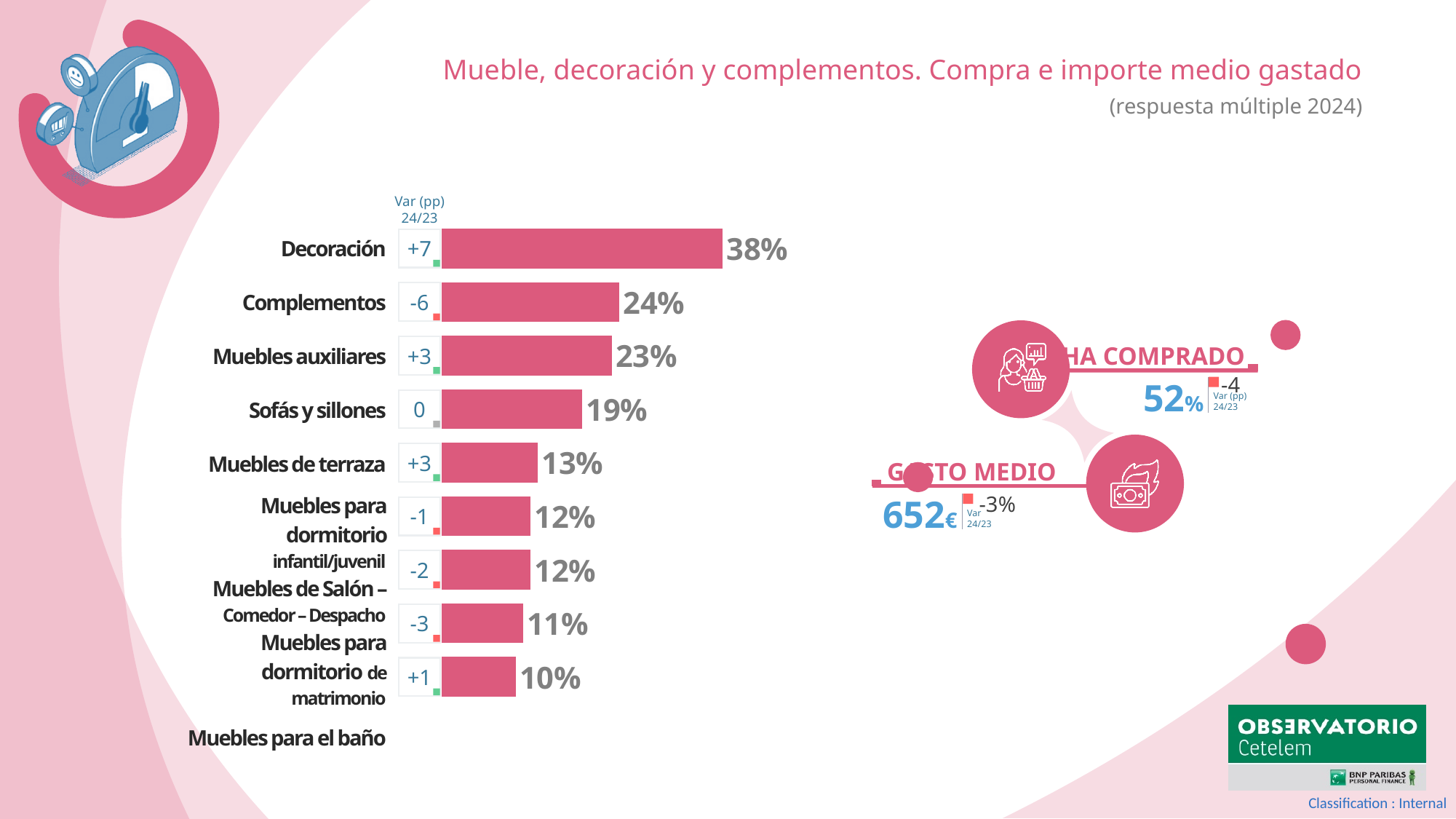
What percentage is shown for Sofás y sillones? 19% What is the Var (pp) 24/23 value shown for Complementos? -6 Which has a higher percentage, Muebles auxiliares or Sofás y sillones? Muebles auxiliares What kind of chart is shown on the slide? Bar chart What percentage is shown for Muebles de terraza? 13% What percentage is shown for Complementos? 24% What is the difference between the percentages for Decoración and Complementos? 14 percentage points Which category has the highest percentage? Decoración What is the Gasto medio value shown on the slide? 652€ What percentage is shown for Decoración? 38% What is the Var (pp) 24/23 value shown for Decoración? +7 How many bars are plotted in the chart? 9